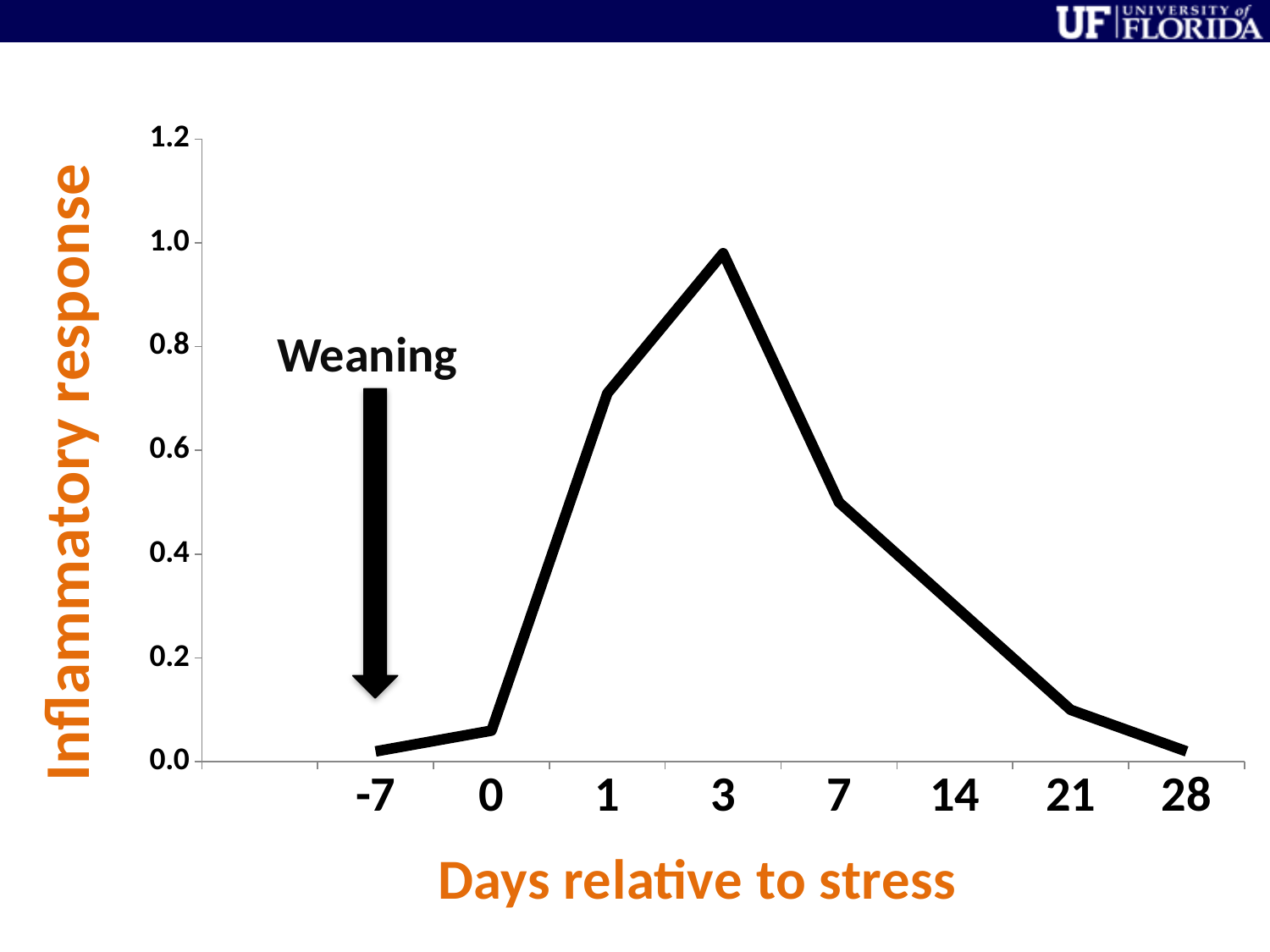
Is the inflammatory response at day 0 greater or less than 0.2? less Is the inflammatory response at day 21 greater or less than 0.2? less Is the inflammatory response at day 1 greater or less than 0.6? greater What kind of chart is shown on the slide? line chart What event does the arrow annotation on the chart mark? Weaning At which day relative to stress is the inflammatory response highest? 3 Which has the larger inflammatory response, day 1 or day 7? day 1 Does the inflammatory response rise or fall between day 3 and day 28? fall How many data points are plotted along the x axis? 8 What is the label on the x axis? Days relative to stress